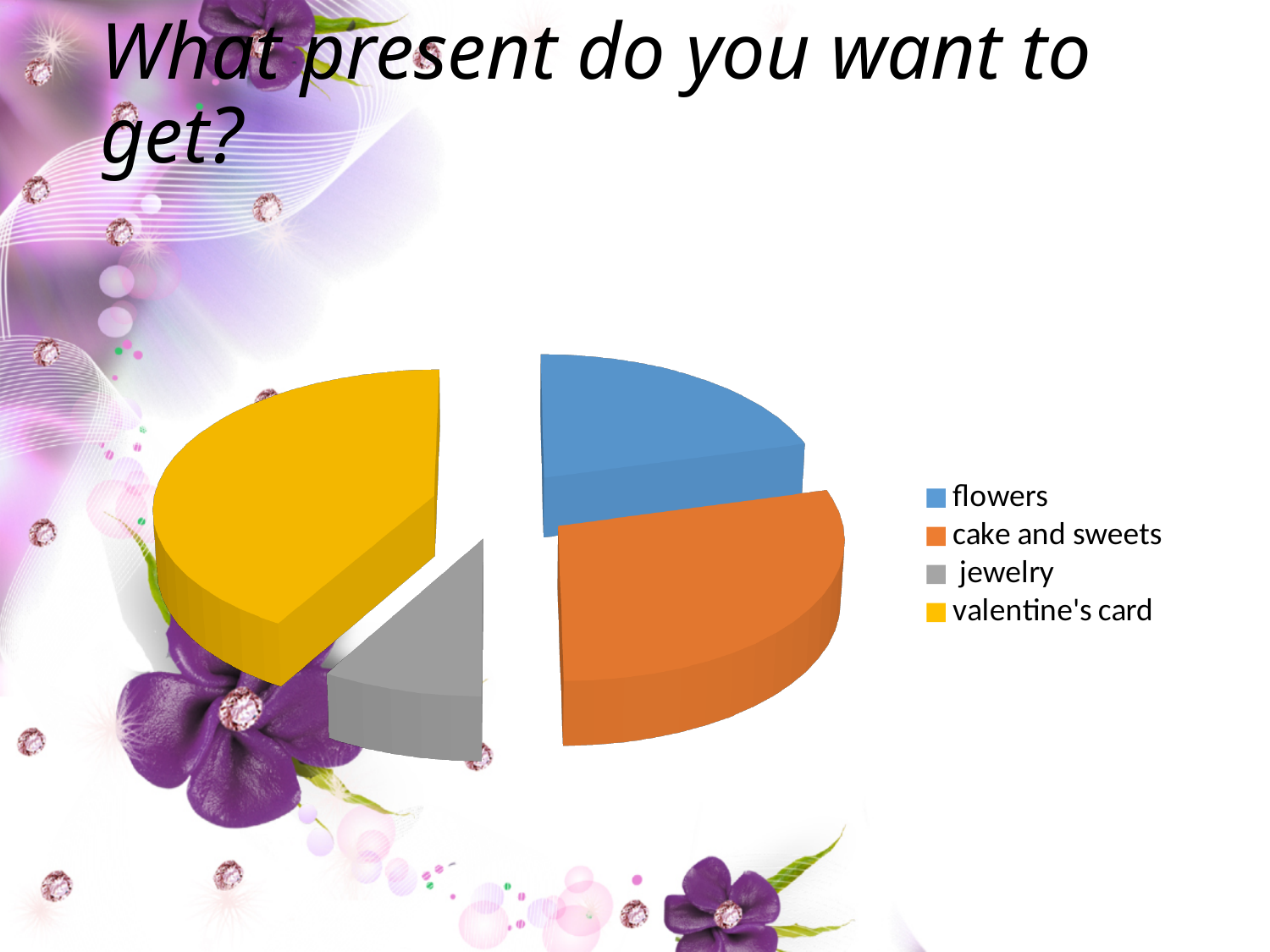
Which slice is larger, cake and sweets or flowers? cake and sweets What is the title of the slide containing the pie chart? What present do you want to get? How many entries does the legend of the pie chart list? 4 Which slice is larger, valentine's card or jewelry? valentine's card Which category has the largest slice of the pie chart? valentine's card Which slice is larger, flowers or jewelry? flowers Which category has the smallest slice of the pie chart? jewelry How many categories (slices) does the pie chart have? 4 What kind of chart is shown on the slide? pie chart What colour is the slice for cake and sweets in the pie chart? orange